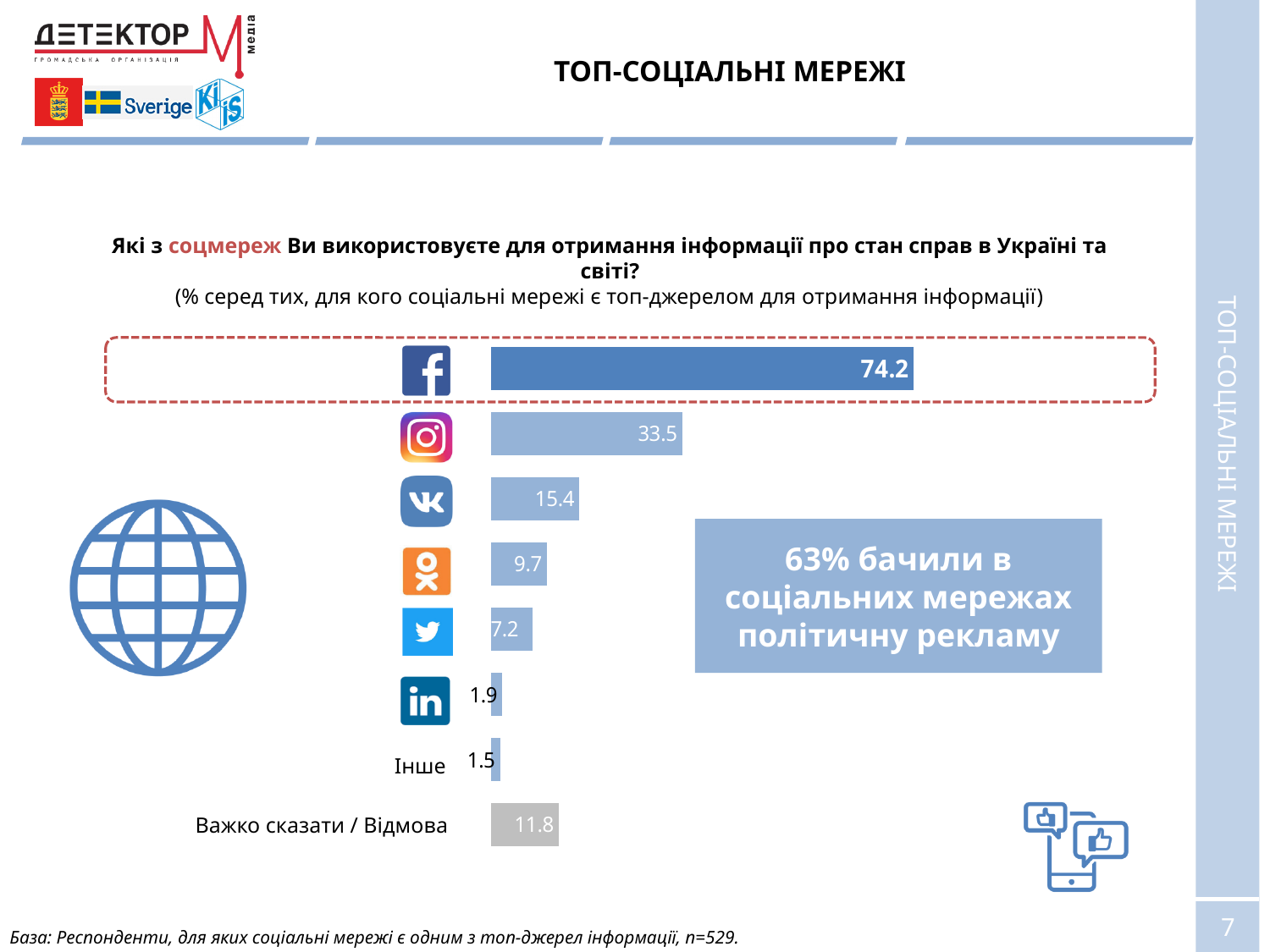
What is the difference between the Facebook and Instagram values? 40.7 What is the value for the Twitter bar? 7.2 What is the value for "Інше"? 1.5 What is the value for the Instagram bar? 33.5 Which is larger, the VK value or the Odnoklassniki value? VK What percentage is stated in the highlighted box about seeing political advertising on social networks? 63% How many bars are shown in the chart? 8 What kind of chart is shown on the slide? Bar chart What is the value for "Важко сказати / Відмова"? 11.8 What is the value for the Facebook bar? 74.2 Which category has the lowest value in the chart? Інше Which social network has the highest value in the chart? Facebook